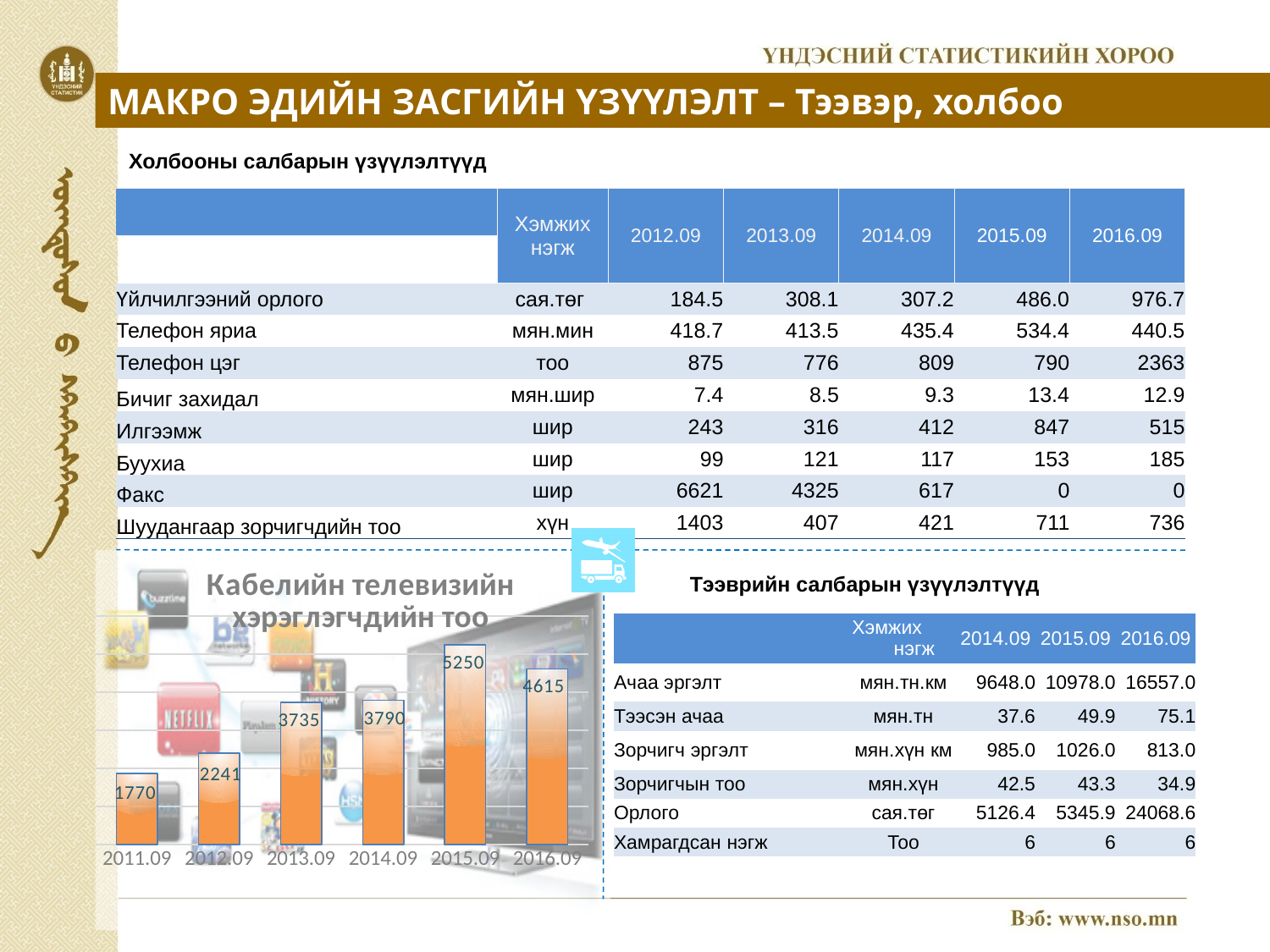
What is the value for 2011.09 in the chart? 1770 What is the value for 2016.09 in the chart? 4615 What is the difference between the values for 2015.09 and 2016.09 in the chart? 635 What is the value for 2013.09 in the chart? 3735 What type of chart is shown on the slide? bar chart What is the title of the chart on the slide? Кабелийн телевизийн хэрэглэгчдийн тоо Which category has the lowest value in the chart? 2011.09 What is the difference between the values for 2012.09 and 2011.09 in the chart? 471 How many categories (time points) are shown on the x axis of the chart? 6 Which category has the highest value in the chart? 2015.09 Which is larger in the chart, the value for 2014.09 or the value for 2012.09? 2014.09 Do the values in the chart rise or fall from 2011.09 to 2015.09? rise